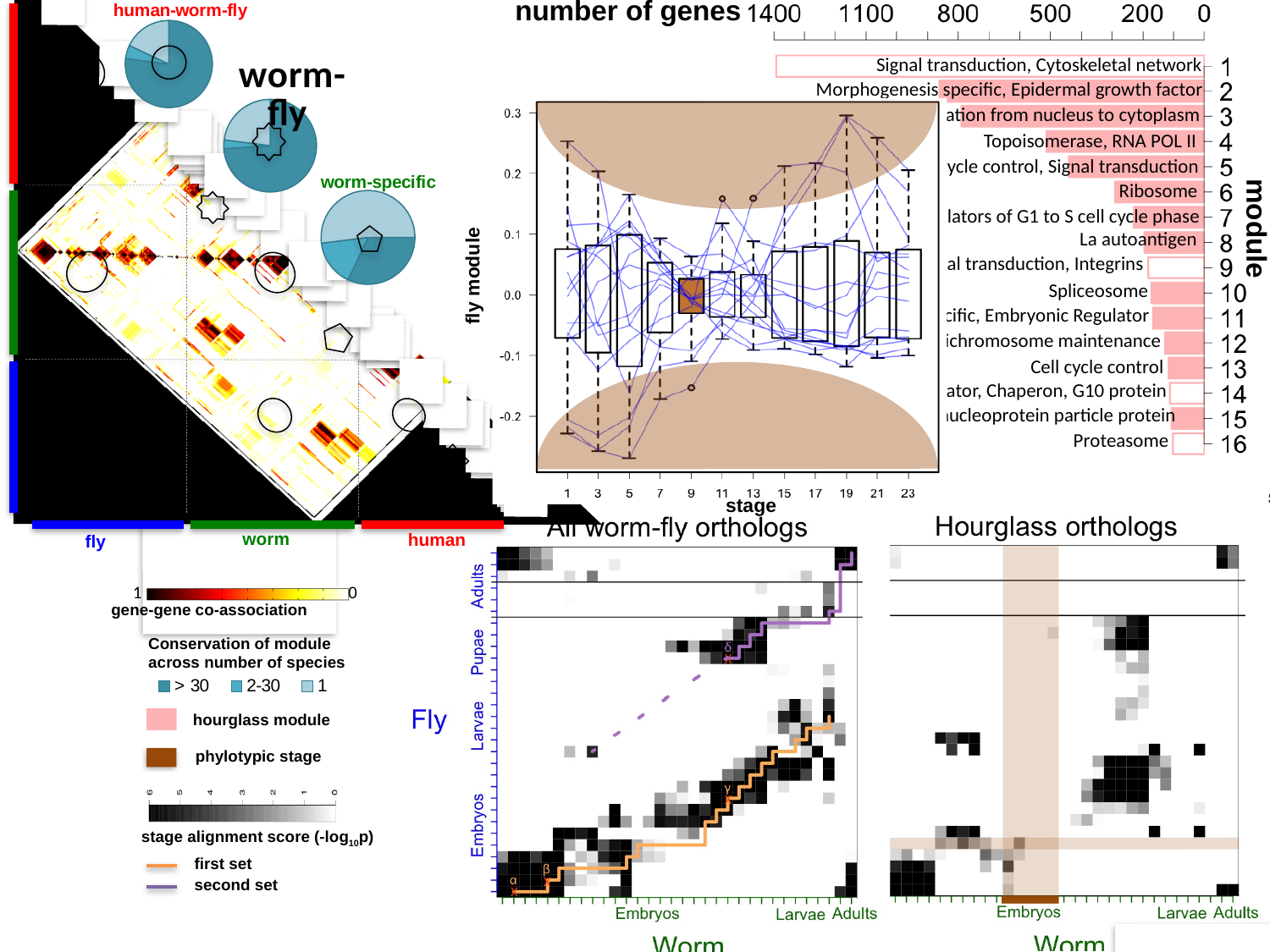
In the 'number of genes' bar chart, which has more genes: module 1 or module 2? Module 1 In the 'number of genes' bar chart, what is the label of module 13? Cell cycle control In the 'number of genes' bar chart, is the number of genes for module 6 (Ribosome) greater or less than 500? less In the box plot of fly module versus stage, how many stages are marked on the x axis? 12 In the 'number of genes' bar chart, which module has the largest number of genes? Module 1 (Signal transduction, Cytoskeletal network) In the 'number of genes' bar chart, is the number of genes for module 1 greater or less than 1100? greater In the box plot of fly module versus stage, which stage is highlighted in brown as the phylotypic stage? 9 In the 'number of genes' bar chart, is the number of genes for module 16 (Proteasome) greater or less than 200? less In the 'number of genes' bar chart, how many modules are listed? 16 What kind of chart is the 'number of genes' chart at the top right? bar chart What are the titles of the two stage-alignment heatmaps at the bottom of the slide? All worm-fly orthologs; Hourglass orthologs